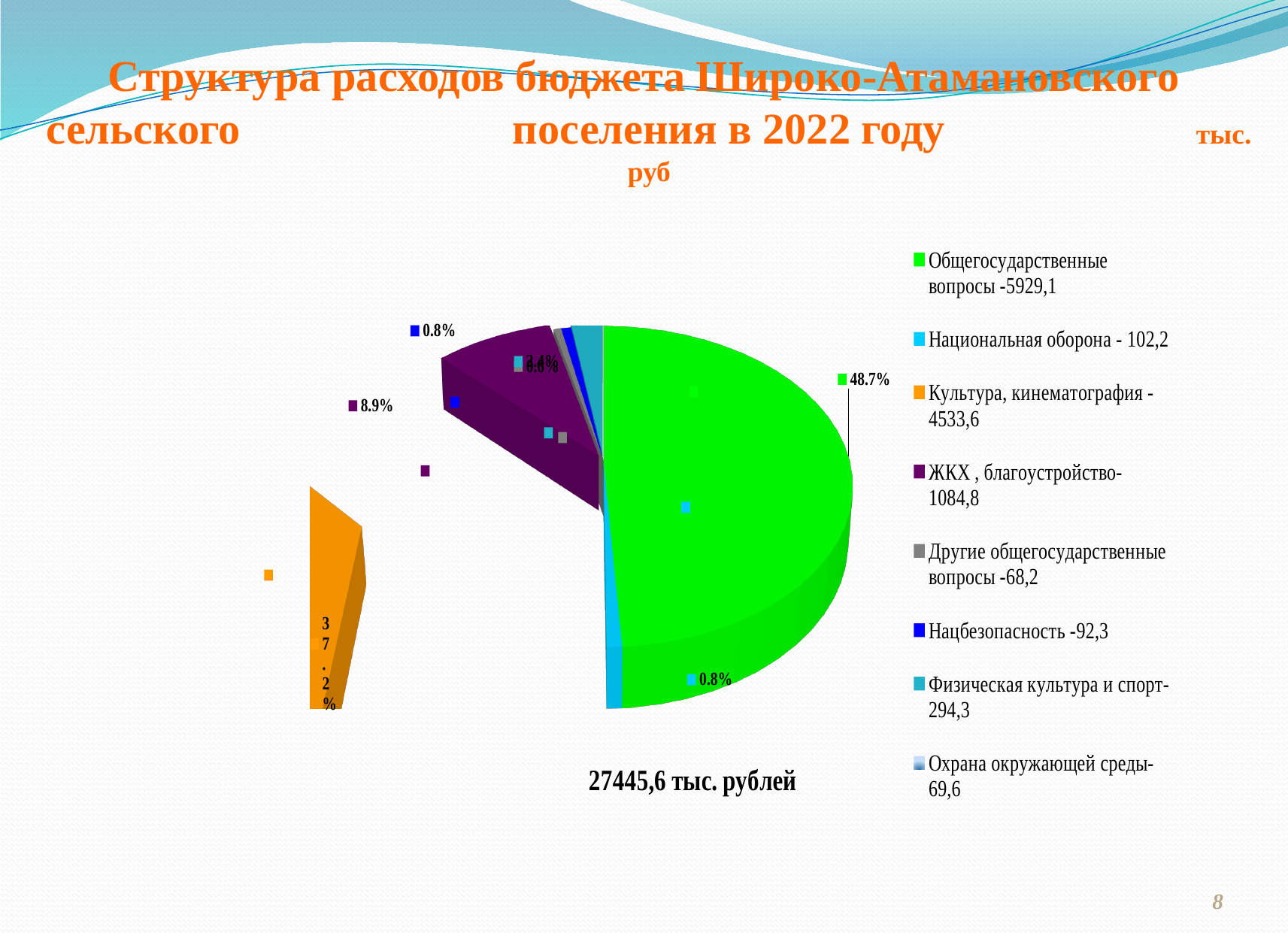
What share of the pie does Культура, кинематография take? 37.2% What share of the pie does ЖКХ, благоустройство take? 8.9% What value does the legend give for Охрана окружающей среды? 69,6 How many categories does the legend of the pie chart list? 8 What is the difference in percentage points between the shares of Общегосударственные вопросы and Культура, кинематография? 11.5% Which category has the largest slice of the pie? Общегосударственные вопросы What value does the legend give for Национальная оборона? 102,2 What kind of chart is shown on the slide? pie chart Which slice is larger: Культура, кинематография or ЖКХ, благоустройство? Культура, кинематография What value does the legend give for Физическая культура и спорт? 294,3 What share of the pie does Общегосударственные вопросы take? 48.7% What total amount is printed below the pie chart? 27445,6 тыс. рублей